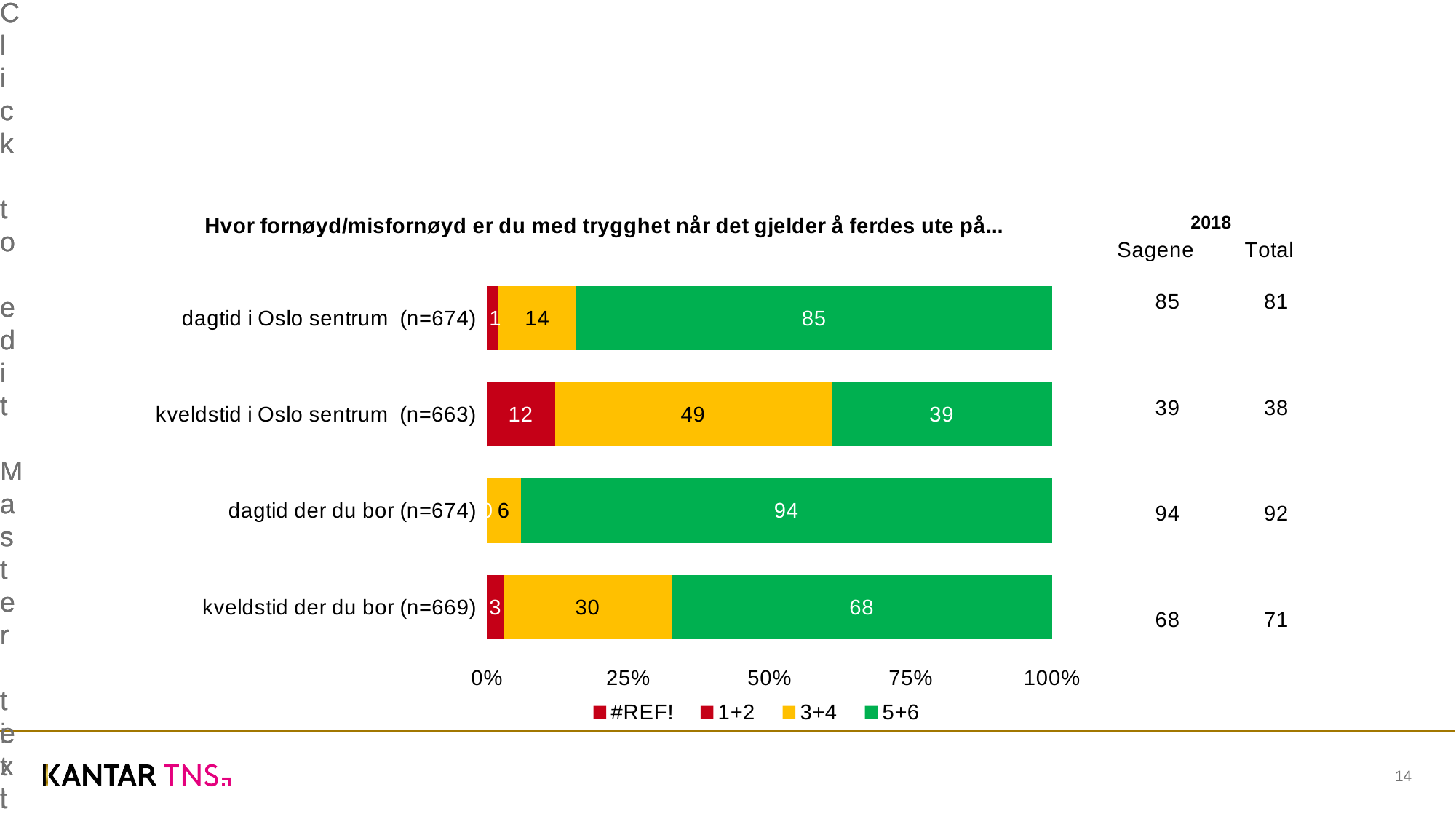
Which is larger: the 3+4 value for 'kveldstid der du bor (n=669)' or the 3+4 value for 'dagtid i Oslo sentrum (n=674)'? kveldstid der du bor (n=669) What is the value of the 3+4 segment for 'kveldstid i Oslo sentrum (n=663)'? 49 Which legend entry is shown in green? 5+6 Which category has the lowest 5+6 value? kveldstid i Oslo sentrum (n=663) What is the difference between the 5+6 values for 'dagtid der du bor (n=674)' and 'kveldstid der du bor (n=669)'? 26 What kind of chart is shown on the slide? stacked bar chart What is the value of the 5+6 segment for 'dagtid i Oslo sentrum (n=674)'? 85 What is the value of the 5+6 segment for 'kveldstid der du bor (n=669)'? 68 Which category has the highest 5+6 value? dagtid der du bor (n=674) What is the value of the 1+2 segment for 'kveldstid i Oslo sentrum (n=663)'? 12 How many series does the legend list? 4 How many categories (bars) does the chart show? 4